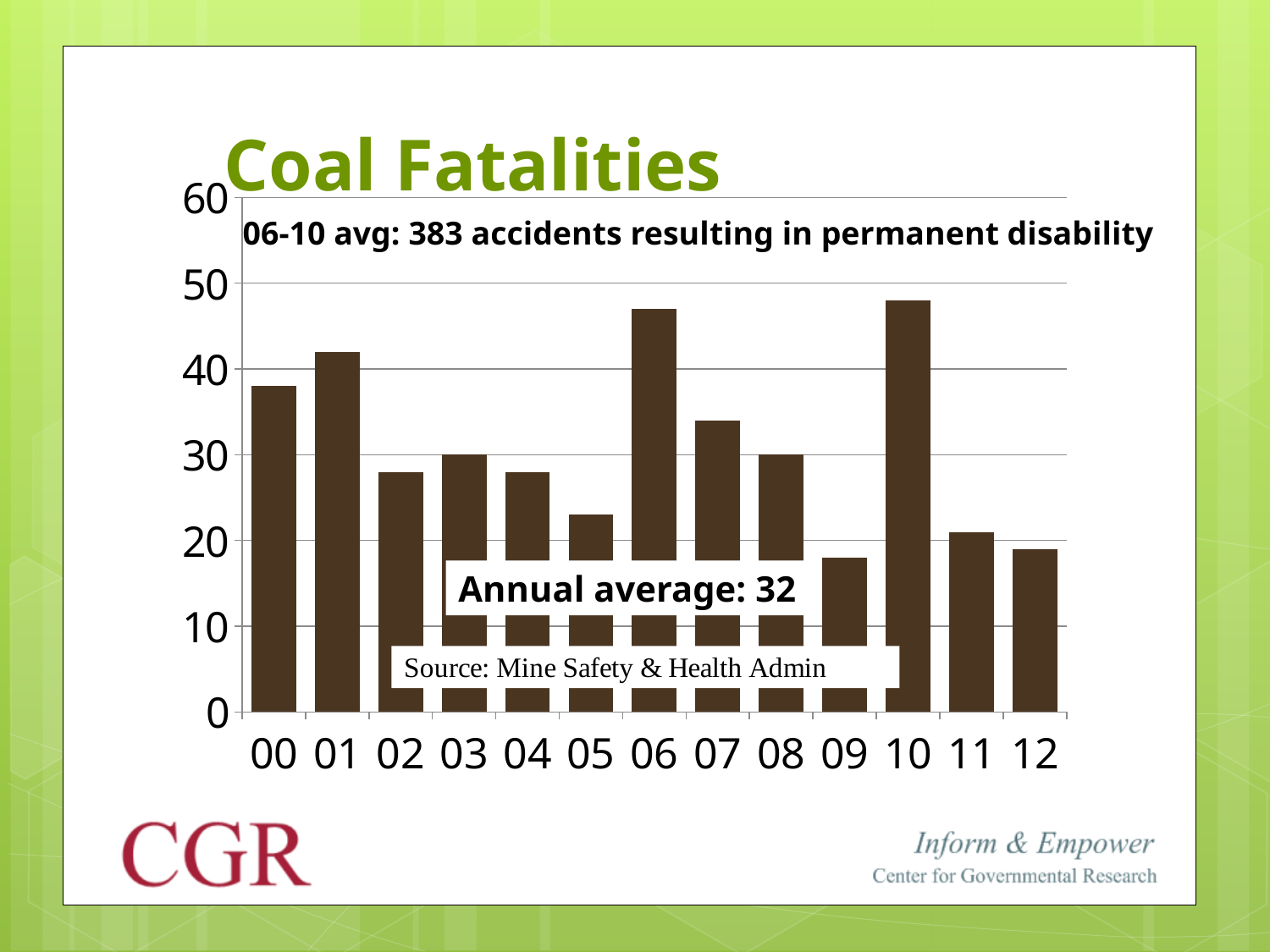
What is the title of the chart? Coal Fatalities Is the value for 00 greater or less than 30? greater How many years (bars) are shown in the Coal Fatalities chart? 13 Is the value for 09 greater or less than 20? less Which year has the higher value, 00 or 01? 01 Is the value for 10 greater or less than 40? greater What kind of chart is shown on the slide? bar chart What annual average is stated on the chart? 32 Which year has the higher value, 06 or 07? 06 Do the values rise or fall from 10 to 12? fall